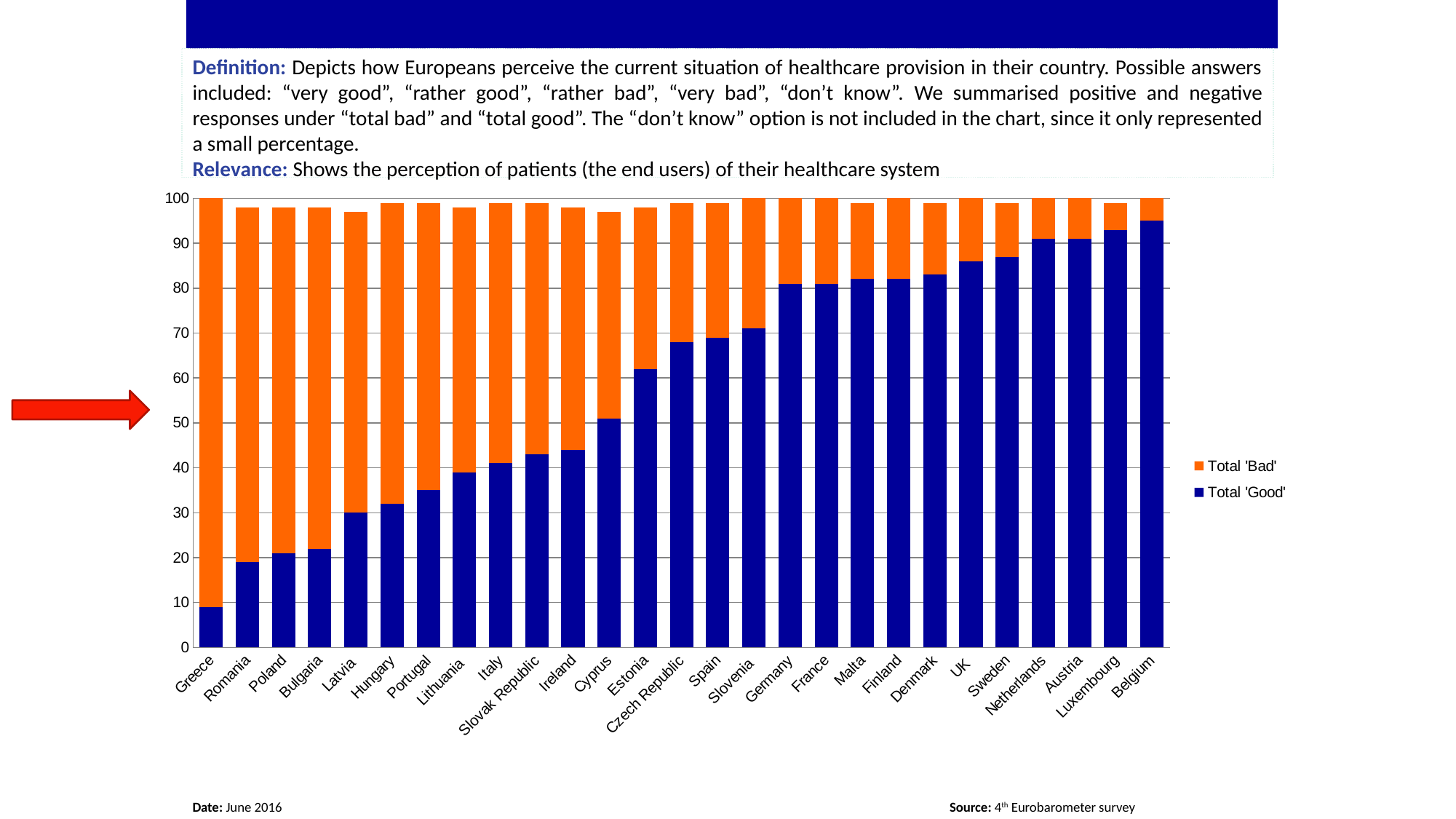
Which country has the largest Total 'Bad' segment? Greece Is the Total 'Good' value for Belgium greater or less than 90? greater How many series does the legend list? 2 Is the Total 'Good' value for Estonia greater or less than 60? greater Which country has the highest Total 'Good' value? Belgium Which has a larger Total 'Good' value, Germany or Romania? Germany Which colour represents Total 'Bad' in the legend? Orange Does the Total 'Good' value rise or fall moving from left to right along the x axis? rise Which country has the lowest Total 'Good' value? Greece How many countries are shown along the x axis? 27 What kind of chart is shown on the slide? Stacked bar chart